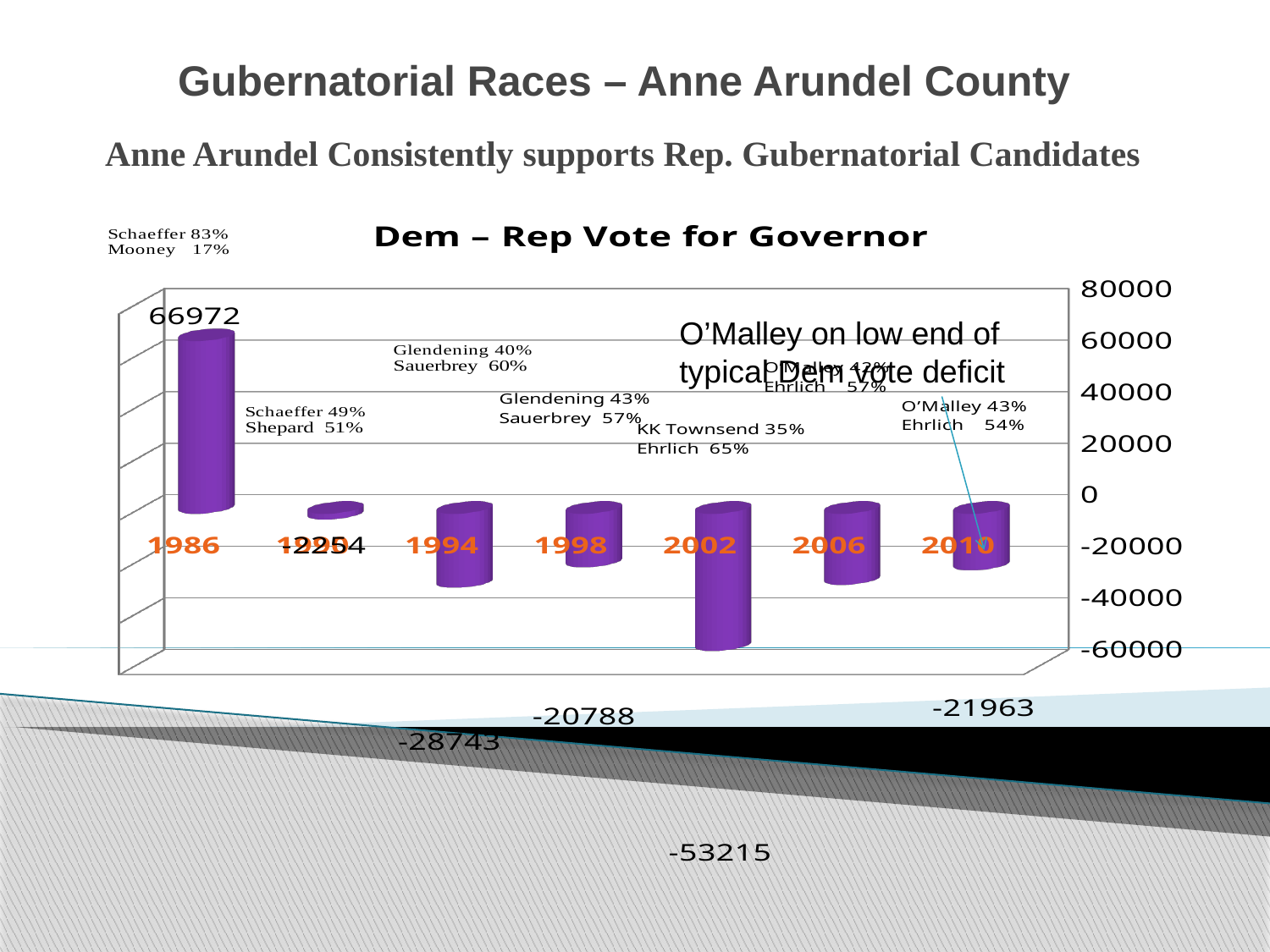
What is the value for 2010? -21963 Which year has the highest value? 1986 What is the value for 1986? 66972 What is the difference between the values for 1998 and 1994? 7955 What is the value for 2002? -53215 What is the value for 1998? -20788 What is the title of the chart? Dem – Rep Vote for Governor Is the value for 2006 greater or less than -20000? less How many election years are plotted on the chart? 7 What is the value for 1994? -28743 What kind of chart is shown on the slide? bar chart Which year has the lowest value? 2002